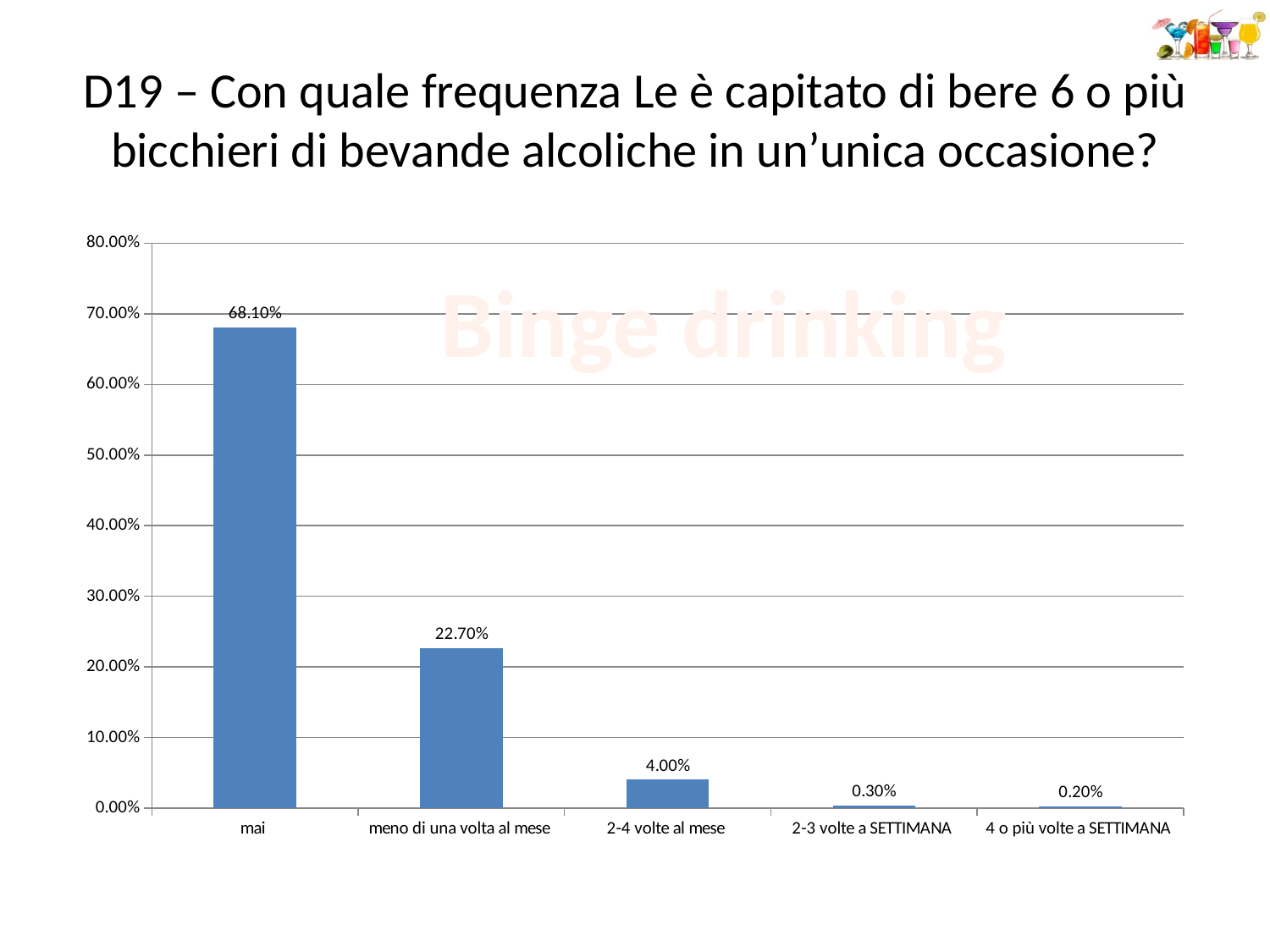
Is the value for "meno di una volta al mese" greater or less than 20.00%? greater Which is larger, the value for "2-4 volte al mese" or the value for "2-3 volte a SETTIMANA"? 2-4 volte al mese Which category has the highest value? mai How many categories are shown on the x axis? 5 What kind of chart is shown on the slide? bar chart Which category has the lowest value? 4 o più volte a SETTIMANA What is the value for "meno di una volta al mese"? 22.70% What is the value for "2-4 volte al mese"? 4.00% What is the value for "4 o più volte a SETTIMANA"? 0.20% What is the difference between the values for "mai" and "meno di una volta al mese"? 45.40% What is the value for "mai"? 68.10% What is the value for "2-3 volte a SETTIMANA"? 0.30%